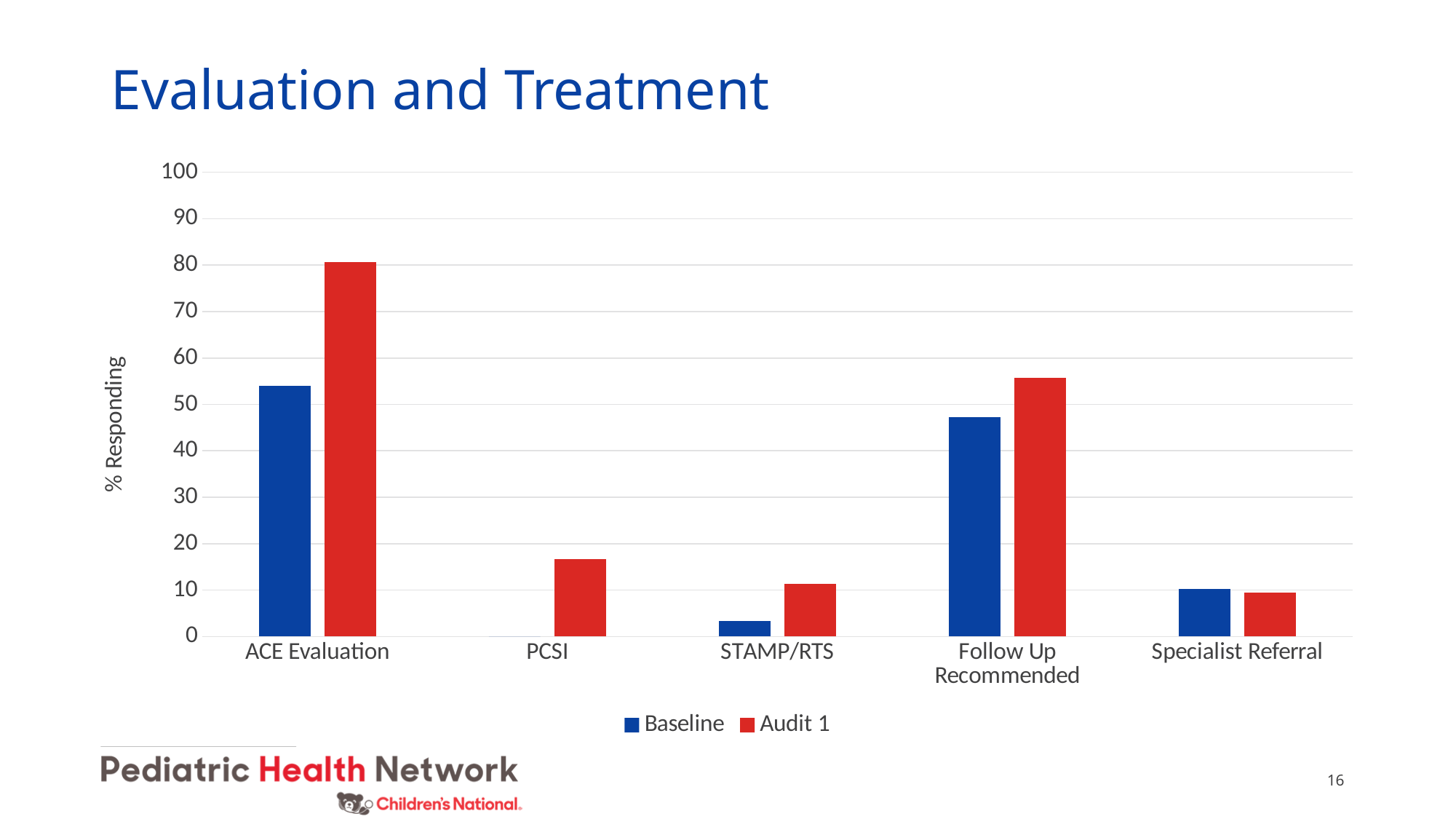
For Follow Up Recommended, which is larger: Baseline or Audit 1? Audit 1 What kind of chart is shown on the slide? Bar chart What is the label on the y axis? % Responding Is the Audit 1 value for PCSI greater or less than 20? less Which category has the highest Audit 1 value? ACE Evaluation How many series does the legend list? 2 Is the Baseline value for ACE Evaluation greater or less than 50? greater How many categories are shown on the x axis? 5 Is the Audit 1 value for Follow Up Recommended greater or less than 50? greater Which category has the lowest Baseline value? PCSI Which category has the highest Baseline value? ACE Evaluation